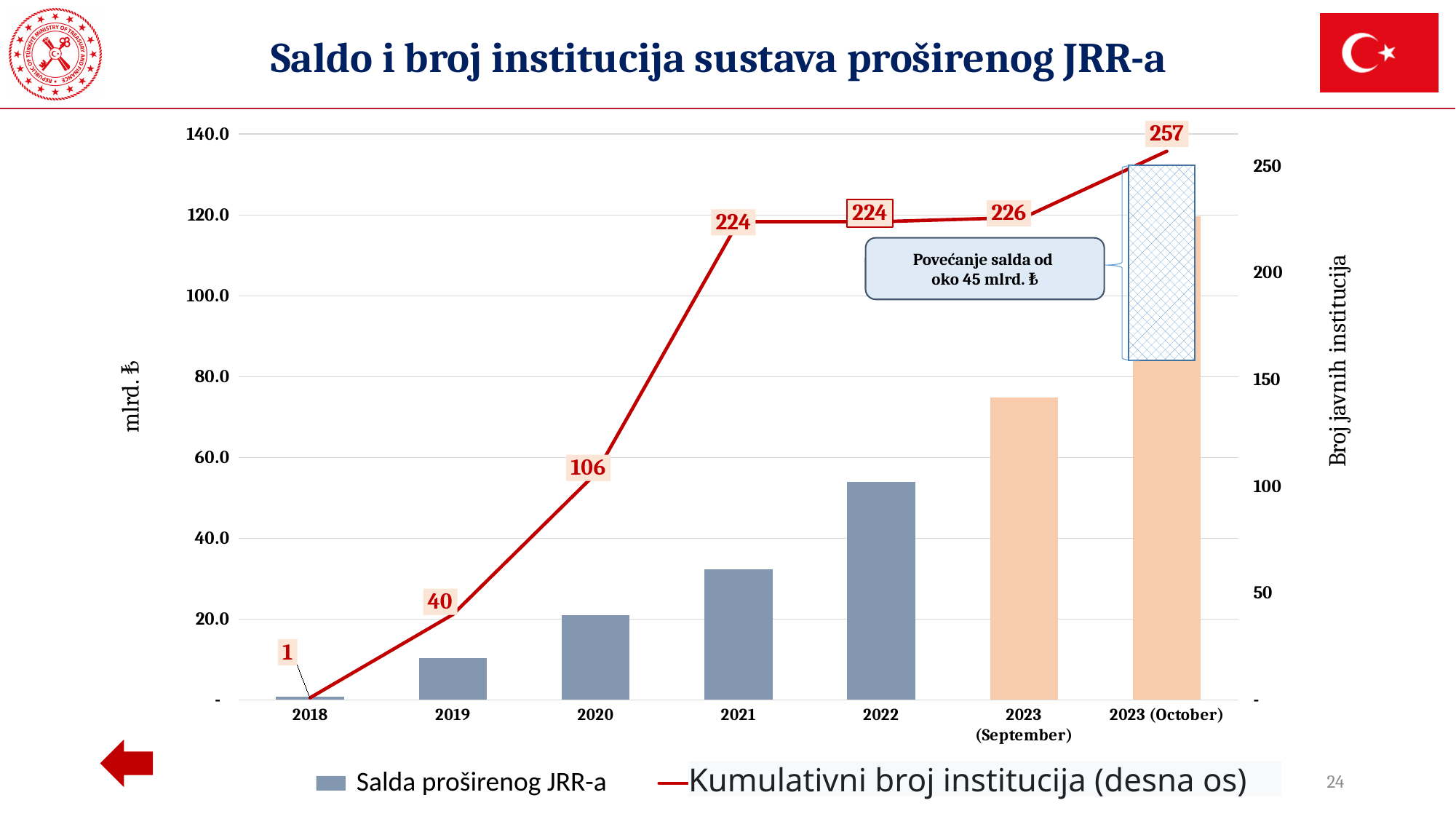
How many series does the legend list? 2 What is the cumulative number of institutions shown for 2019? 40 Is the balance (Salda proširenog JRR-a) bar for 2020 greater or less than 40.0 mlrd. ₺? less Which has a larger cumulative number of institutions, 2019 or 2020? 2020 In which year is the cumulative number of institutions lowest? 2018 What is the cumulative number of institutions shown for 2020? 106 What is the cumulative number of institutions shown for 2023 (October)? 257 Is the balance (Salda proširenog JRR-a) bar for 2022 greater or less than 40.0 mlrd. ₺? greater Does the cumulative number of institutions rise or fall from 2018 to 2023 (October)? rise By how much did the cumulative number of institutions increase from 2023 (September) to 2023 (October)? 31 In which period is the cumulative number of institutions highest? 2023 (October) How many time periods are shown on the x axis? 7